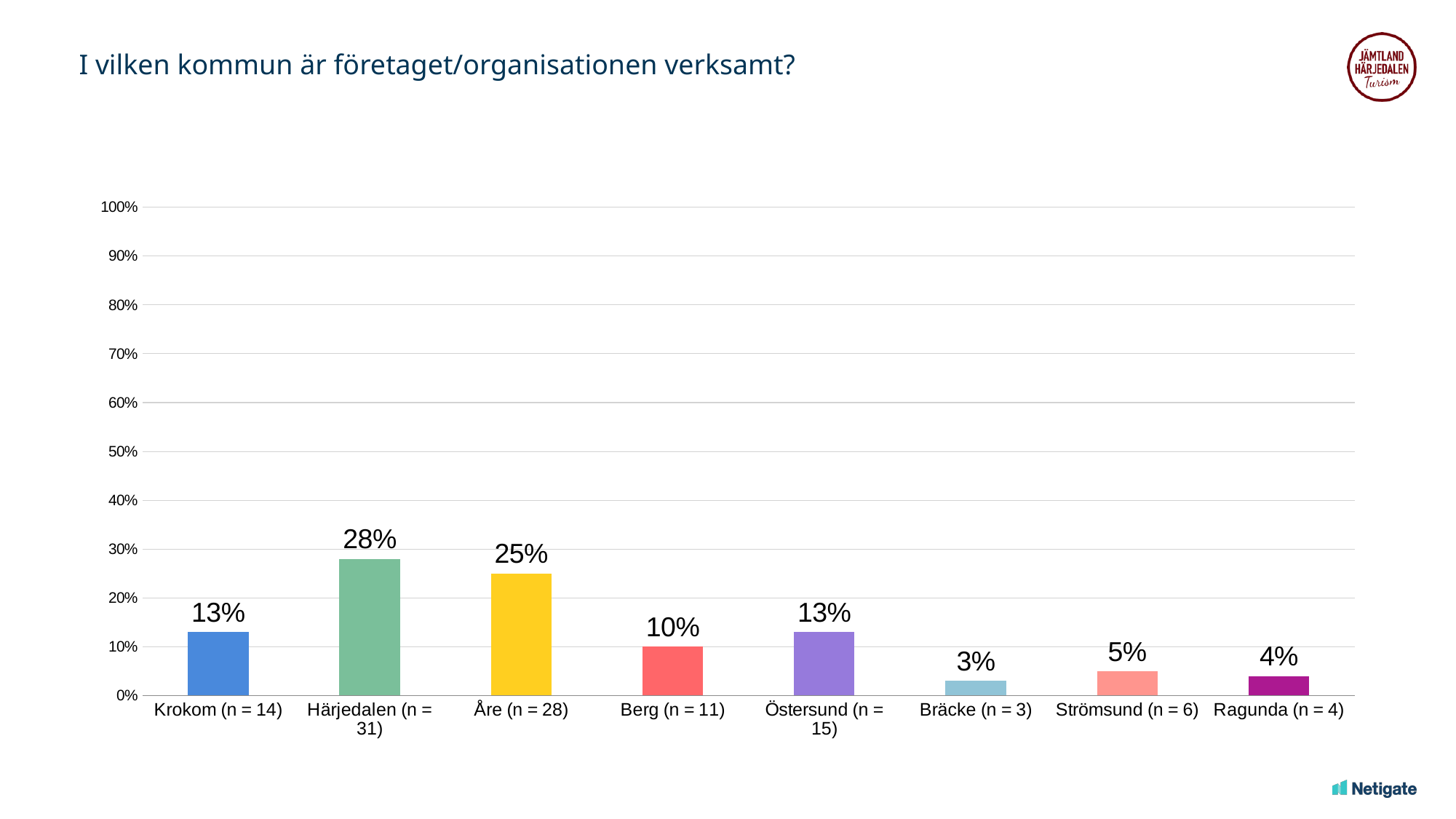
What is the value for Åre (n = 28)? 25% What is the value for Härjedalen (n = 31)? 28% Which is larger, the value for Berg (n = 11) or the value for Östersund (n = 15)? Östersund (n = 15) Which municipality has the highest value? Härjedalen (n = 31) What is the value for Strömsund (n = 6)? 5% What kind of chart is shown on the slide? Bar chart What is the difference between the values for Härjedalen (n = 31) and Åre (n = 28)? 3% What is the difference between the values for Krokom (n = 14) and Ragunda (n = 4)? 9% Which municipality has the lowest value? Bräcke (n = 3) What is the title of the chart? I vilken kommun är företaget/organisationen verksamt? What is the value for Berg (n = 11)? 10% How many municipalities are shown on the chart? 8